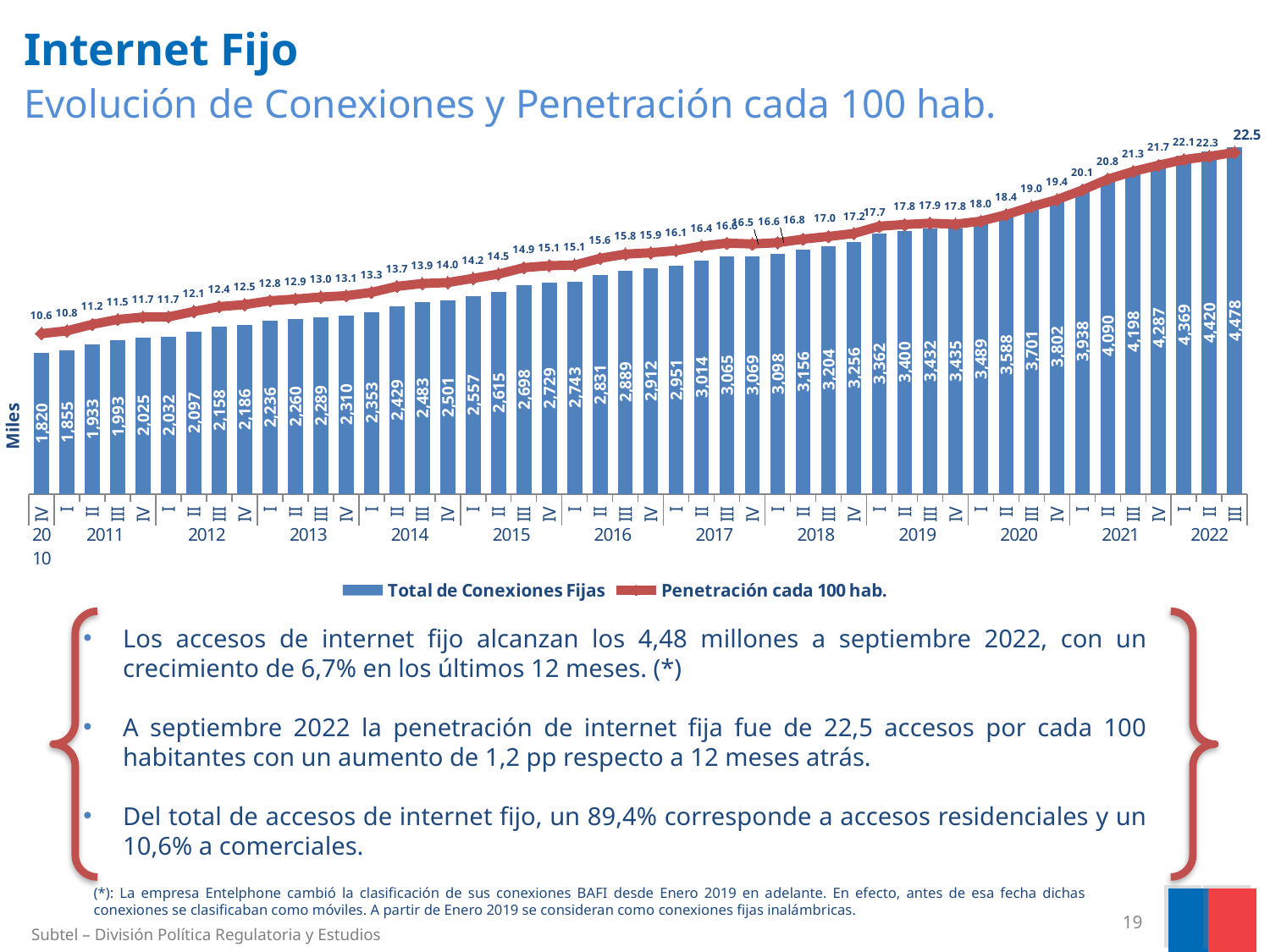
Which quarter has the lowest Penetración cada 100 hab.? IV 2010 Which is larger, the Total de Conexiones Fijas in quarter I of 2019 or in quarter IV of 2018? I 2019 How many series does the legend list? 2 What kind of chart is used to show Total de Conexiones Fijas? Bar chart Which quarter has the highest Total de Conexiones Fijas? III 2022 What is the value of Total de Conexiones Fijas for quarter IV of 2010? 1,820 What is the difference in Total de Conexiones Fijas between quarter III of 2022 and quarter III of 2021? 280 What is the Penetración cada 100 hab. value for quarter III of 2022? 22.5 Does the Penetración cada 100 hab. line generally rise or fall from 2010 to 2022? Rise What is the value of Total de Conexiones Fijas for quarter III of 2022? 4,478 How many quarters (bars) are plotted in the chart? 48 What is the Penetración cada 100 hab. value for quarter IV of 2010? 10.6